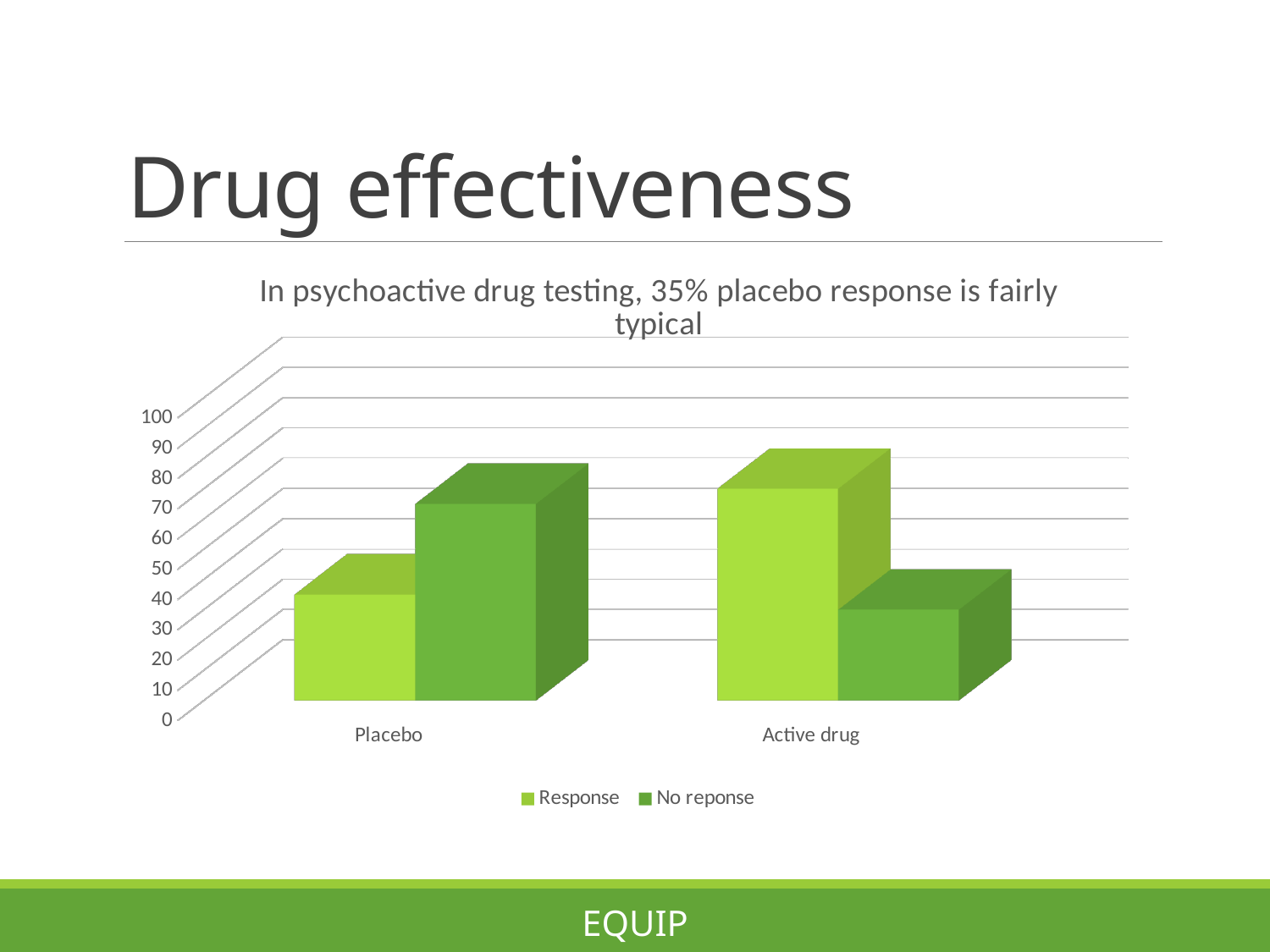
How many categories are shown on the x axis of the chart? 2 How many series does the chart legend list? 2 Is the No reponse value for Active drug greater or less than 50? less What is the title of the chart? In psychoactive drug testing, 35% placebo response is fairly typical For Placebo, which is larger: Response or No reponse? No reponse Is the Response value for Placebo greater or less than 50? less Is the No reponse value for Placebo greater or less than 50? greater Which category has the higher Response value, Placebo or Active drug? Active drug What are the two series named in the chart legend? Response and No reponse Which category has the higher No reponse value, Placebo or Active drug? Placebo What kind of chart is shown on the slide? bar chart